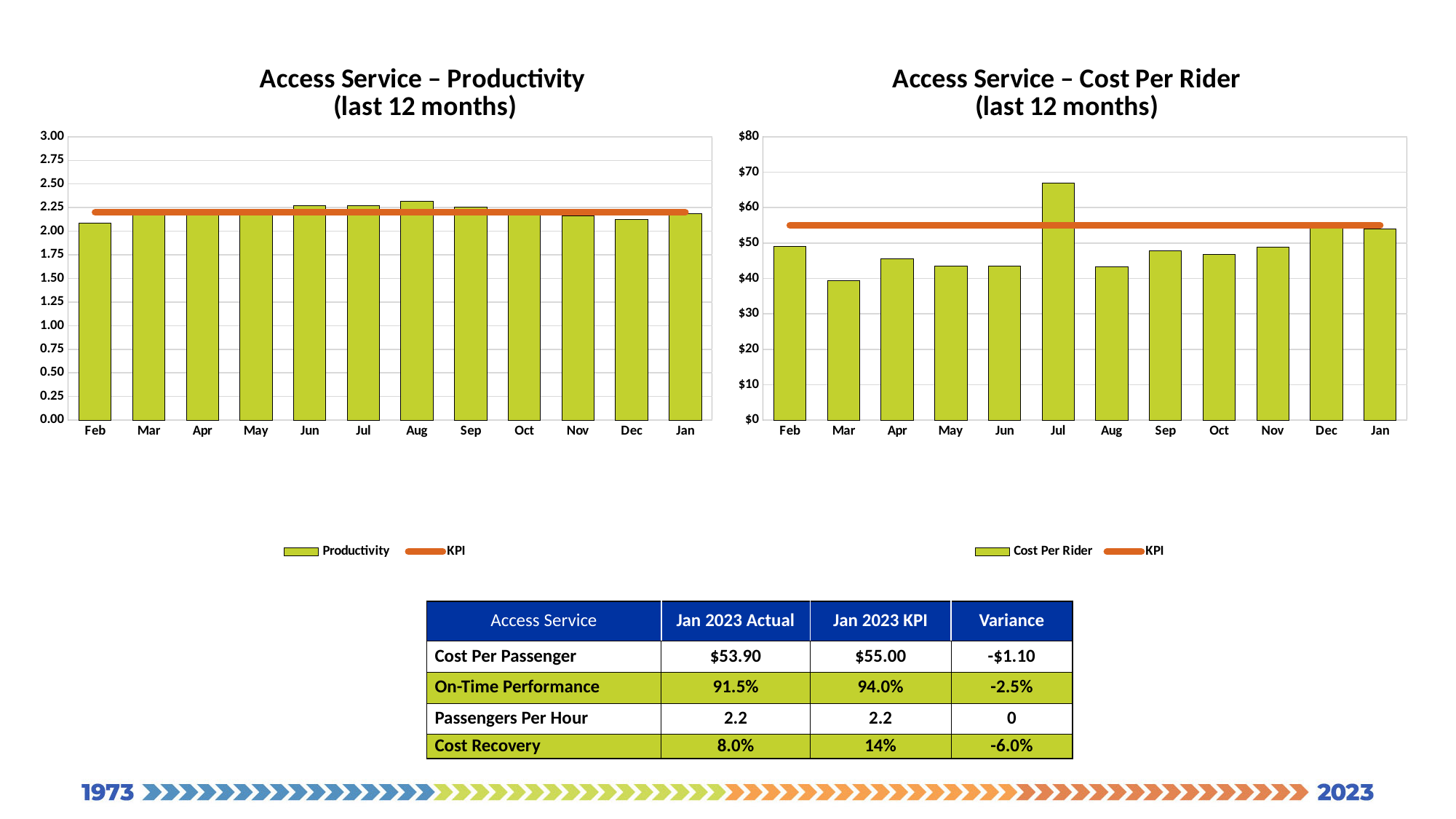
In the Access Service – Cost Per Rider chart, is the cost per rider for Jul larger or smaller than for Aug? larger In the Access Service – Productivity chart, which month has the highest productivity bar? Aug What are the two legend entries of the Access Service – Cost Per Rider chart? Cost Per Rider and KPI In the Access Service – Cost Per Rider chart, which month has the lowest cost per rider? Mar In the Access Service – Cost Per Rider chart, is the value for Jul greater or less than $60? greater In the Access Service – Cost Per Rider chart, is the value for Mar greater or less than $50? less How many months are shown on the x axis of the Access Service – Productivity chart? 12 In the Access Service – Cost Per Rider chart, which month has the highest cost per rider? Jul In the Access Service – Productivity chart, is the value for Feb greater or less than 2.00? greater What kind of chart is the Access Service – Productivity chart? Combination bar and line chart (bars for Productivity with a KPI line) How many series does the legend of the Access Service – Cost Per Rider chart list? 2 In the Access Service – Productivity chart, which month has the lowest productivity bar? Feb